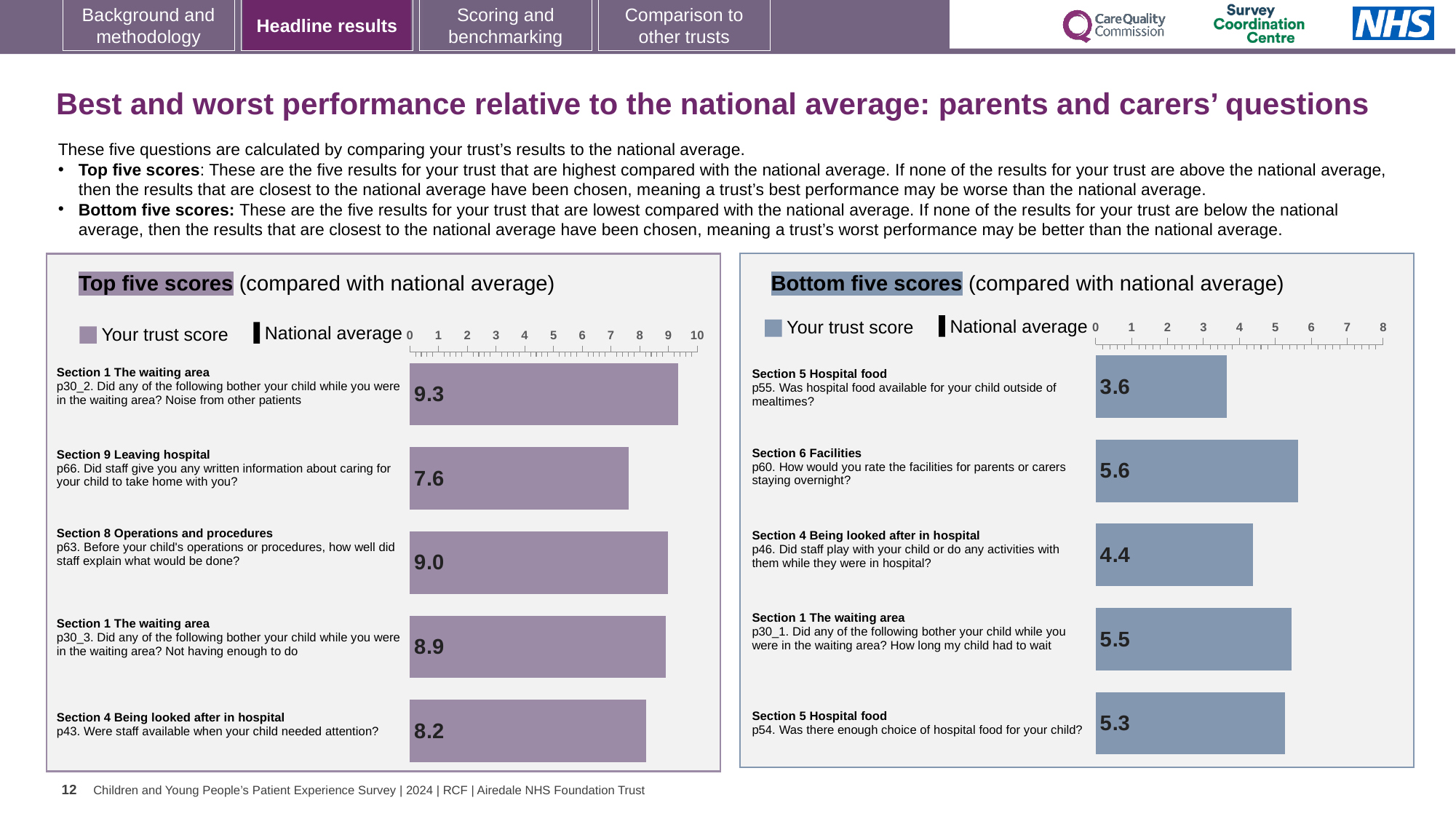
What type of chart is used for the Top five scores? Bar chart In the Top five scores chart, what is the difference between the trust scores for p30_2 (9.3) and p66 (7.6)? 1.7 In the Bottom five scores chart, what is the trust score for p46 'Did staff play with your child or do any activities with them while they were in hospital?' 4.4 In the Bottom five scores chart, which question has the lowest trust score? p55. Was hospital food available for your child outside of mealtimes? (3.6) In the Top five scores chart, what is the trust score for p66 'Did staff give you any written information about caring for your child to take home with you?' 7.6 In the Bottom five scores chart, which question has the highest trust score? p60. How would you rate the facilities for parents or carers staying overnight? (5.6) In the Top five scores chart, which has the larger trust score: p63 (operations and procedures) or p30_3 (not having enough to do)? p63 (9.0) How many bars are plotted in the Bottom five scores chart? 5 In the Bottom five scores chart, what is the difference between the trust scores for p60 and p55? 2.0 In the Top five scores chart, which question has the highest trust score? p30_2. Noise from other patients (9.3) How many entries does the legend of the Bottom five scores chart list? 2 In the Top five scores chart, which question has the lowest trust score? p66. Written information about caring for your child to take home (7.6)